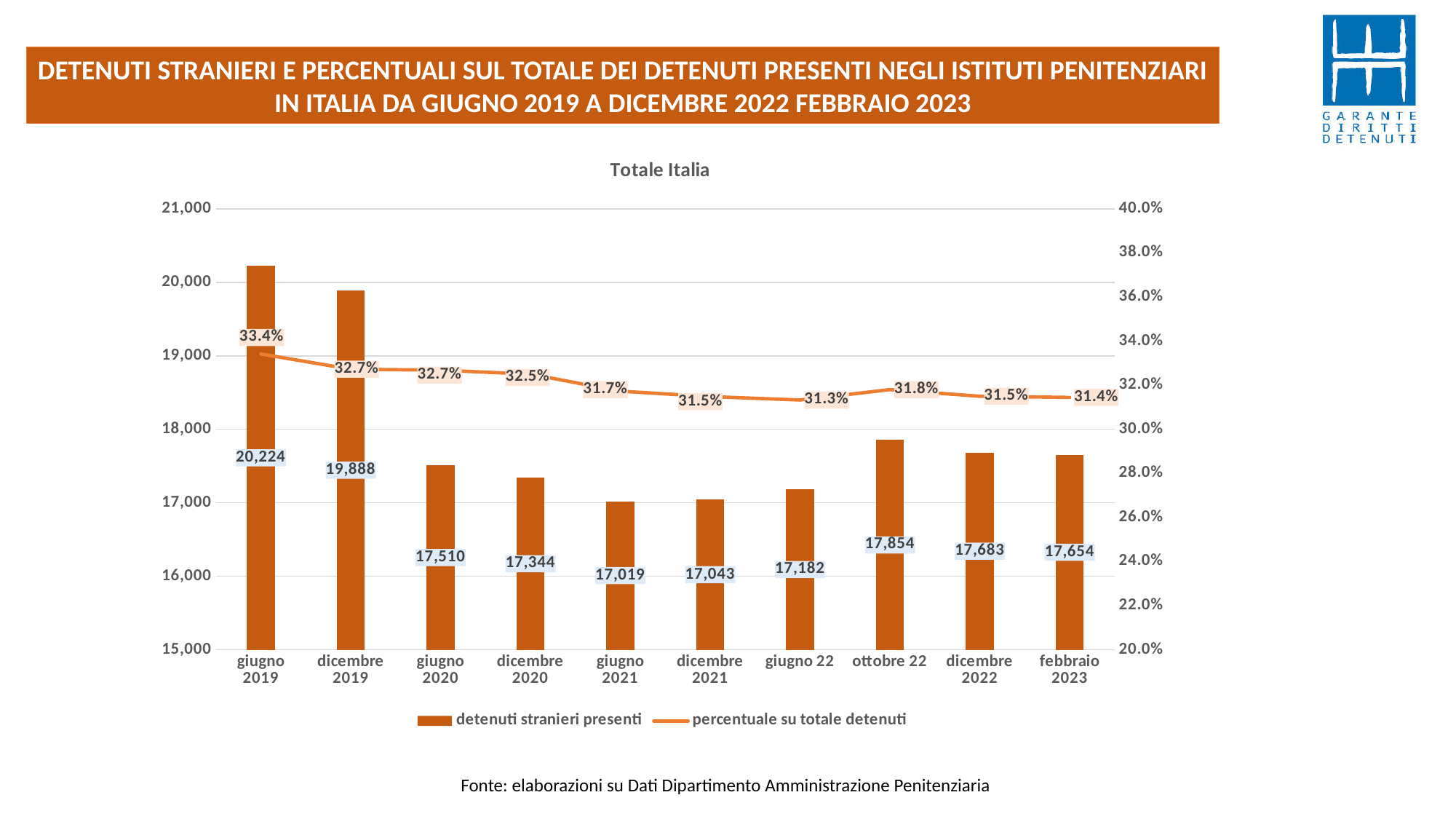
What is the percentuale su totale detenuti for dicembre 2021? 31.5% What is the title of the chart? Totale Italia Which period has the lowest number of detenuti stranieri presenti? giugno 2021 Which period has the highest number of detenuti stranieri presenti? giugno 2019 What kind of chart is used for the detenuti stranieri presenti series? bar chart What is the value of detenuti stranieri presenti for giugno 2019? 20,224 What is the difference in detenuti stranieri presenti between giugno 2019 and dicembre 2019? 336 How many series does the legend list? 2 Which is larger, the number of detenuti stranieri presenti in ottobre 22 or in dicembre 2022? ottobre 22 What is the value of detenuti stranieri presenti for febbraio 2023? 17,654 How many periods are shown on the x axis? 10 Which period has the lowest percentuale su totale detenuti? giugno 22